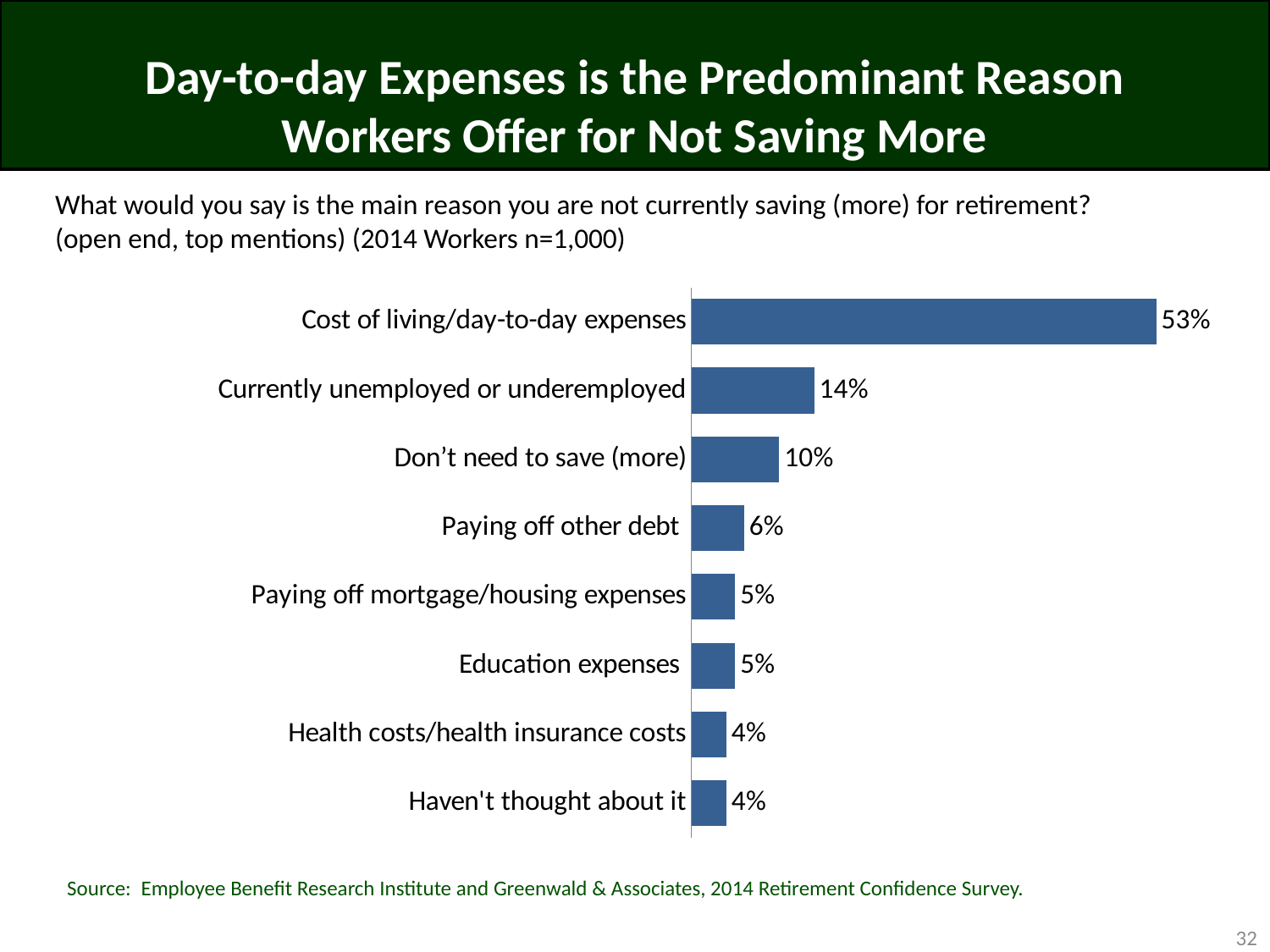
What percentage of workers cited cost of living/day-to-day expenses as the main reason for not saving more? 53% What is the value for 'Paying off other debt'? 6% What is the difference in percentage points between 'Cost of living/day-to-day expenses' and 'Currently unemployed or underemployed'? 39 percentage points How many reasons (categories) are shown in the chart? 8 What is the sample size of workers noted in the question text above the chart? n=1,000 What percentage of workers said they don't need to save (more)? 10% What is the difference between 'Don't need to save (more)' and 'Paying off other debt'? 4 percentage points Which is larger: the value for 'Paying off other debt' or the value for 'Education expenses'? Paying off other debt What type of chart is shown on the slide? Bar chart Which reason has the highest percentage? Cost of living/day-to-day expenses What is the value for 'Currently unemployed or underemployed'? 14% What percentage cited health costs/health insurance costs? 4%